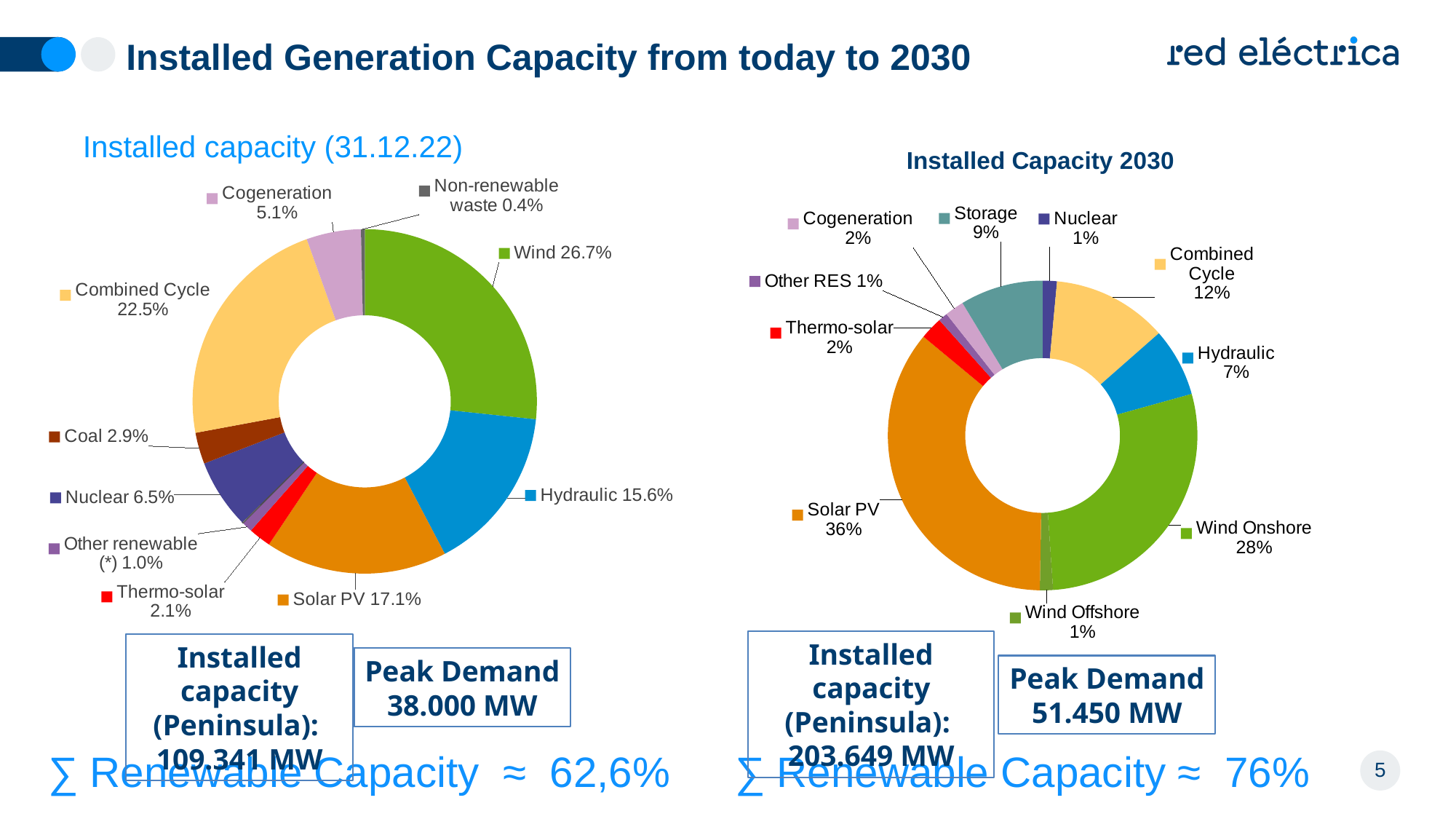
In the 'Installed capacity (31.12.22)' chart, what is the difference between the Solar PV share and the Hydraulic share? 1.5% In the 'Installed Capacity 2030' chart, which category has the largest share? Solar PV In the 'Installed capacity (31.12.22)' chart, what share does Combined Cycle have? 22.5% In the 'Installed Capacity 2030' chart, what share does Storage have? 9% In the 'Installed Capacity 2030' chart, what is the difference between the Wind Onshore share and the Combined Cycle share? 16% In the 'Installed capacity (31.12.22)' chart, how many categories are shown? 10 In the 'Installed capacity (31.12.22)' chart, which category has the largest share? Wind In the 'Installed Capacity 2030' chart, which is larger, Combined Cycle or Hydraulic? Combined Cycle In the 'Installed Capacity 2030' chart, what share does Solar PV have? 36% In the 'Installed capacity (31.12.22)' chart, what share does Wind have? 26.7% What type of chart is used for 'Installed Capacity 2030'? Pie (donut) chart